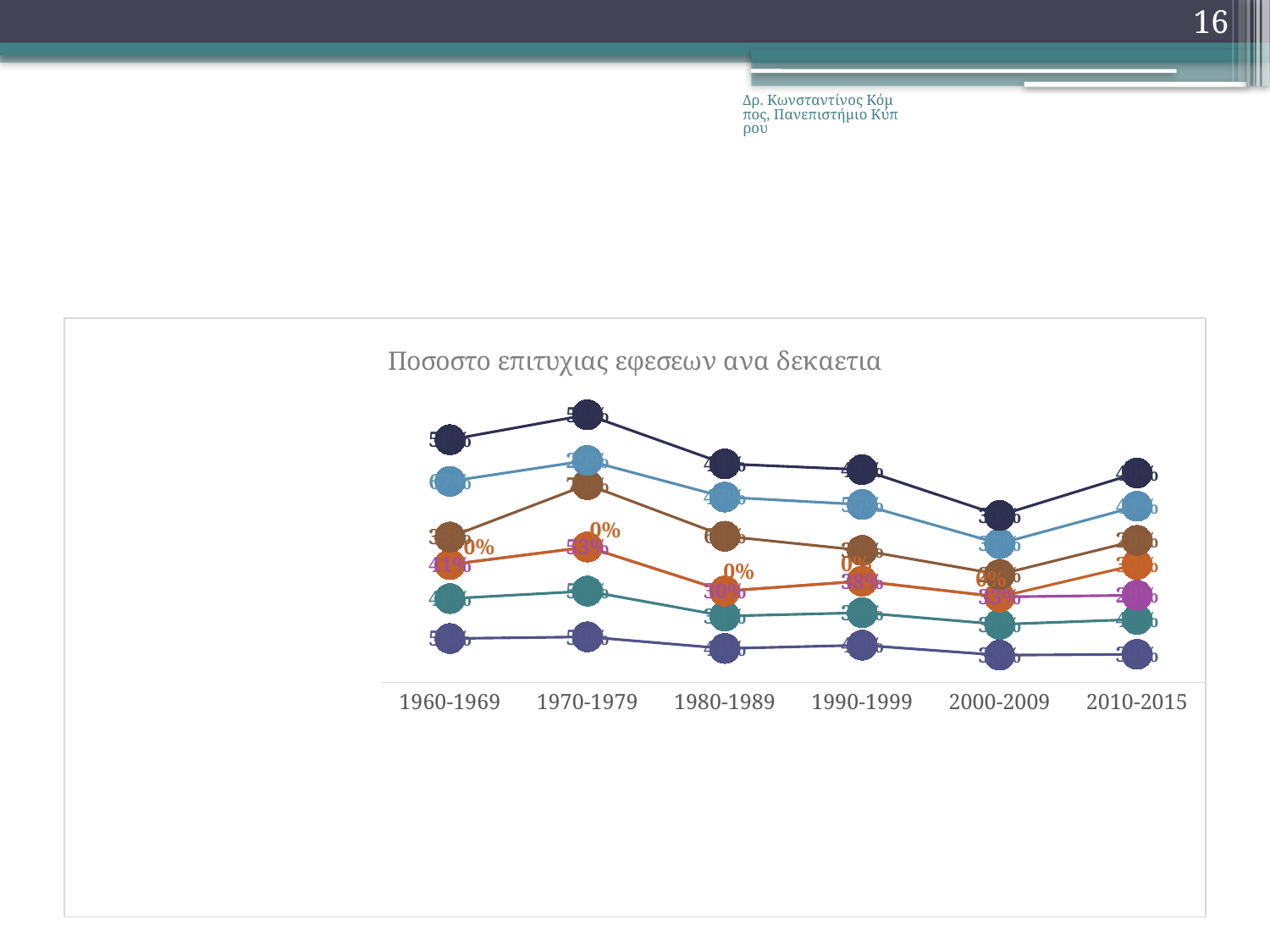
For the topmost (dark navy) line, which decade has the highest point? 1970-1979 For the topmost (dark navy) line, which decade has the lowest point? 2000-2009 What value is labelled on the orange line at 1980-1989? 30% What is the first category on the x axis? 1960-1969 What value is labelled on the orange line at 1990-1999? 38% What value is labelled on the orange line at 1970-1979? 53% What kind of chart is shown on the slide? line chart For the topmost (dark navy) line, is the value for 1970-1979 or 2000-2009 larger? 1970-1979 How many decade categories are shown on the x axis? 6 Does the topmost (dark navy) line rise or fall from 1970-1979 to 2000-2009? fall Does the topmost (dark navy) line rise or fall from 2000-2009 to 2010-2015? rise What is the title of the chart? Ποσοστο επιτυχιας εφεσεων ανα δεκαετια